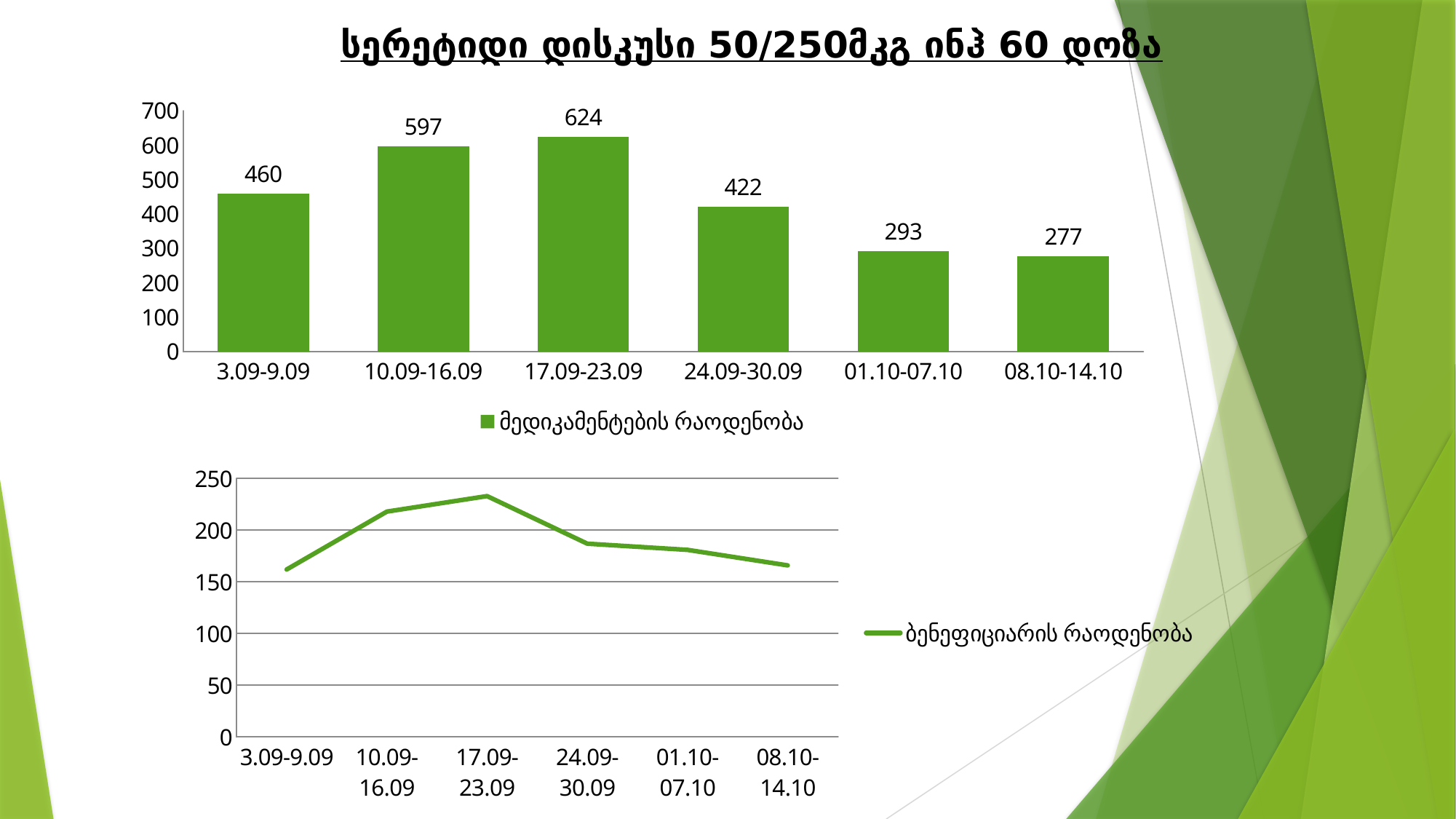
In the bottom line chart, is the value for 17.09-23.09 greater or less than 200? greater How many bars are in the top bar chart? 6 In the top bar chart, which period has the highest value? 17.09-23.09 In the top bar chart, what is the difference between the values for 10.09-16.09 and 24.09-30.09? 175 In the top bar chart, which period has the lowest value? 08.10-14.10 What kind of chart is the top chart on the slide? bar chart In the top bar chart, what is the value for 01.10-07.10? 293 What kind of chart is the bottom chart on the slide? line chart In the bottom line chart, do the values rise or fall from 17.09-23.09 to 08.10-14.10? fall In the bottom line chart, is the value for 08.10-14.10 greater or less than 200? less In the top bar chart, which is larger: the value for 3.09-9.09 or the value for 24.09-30.09? 3.09-9.09 In the top bar chart, what is the value for 17.09-23.09? 624